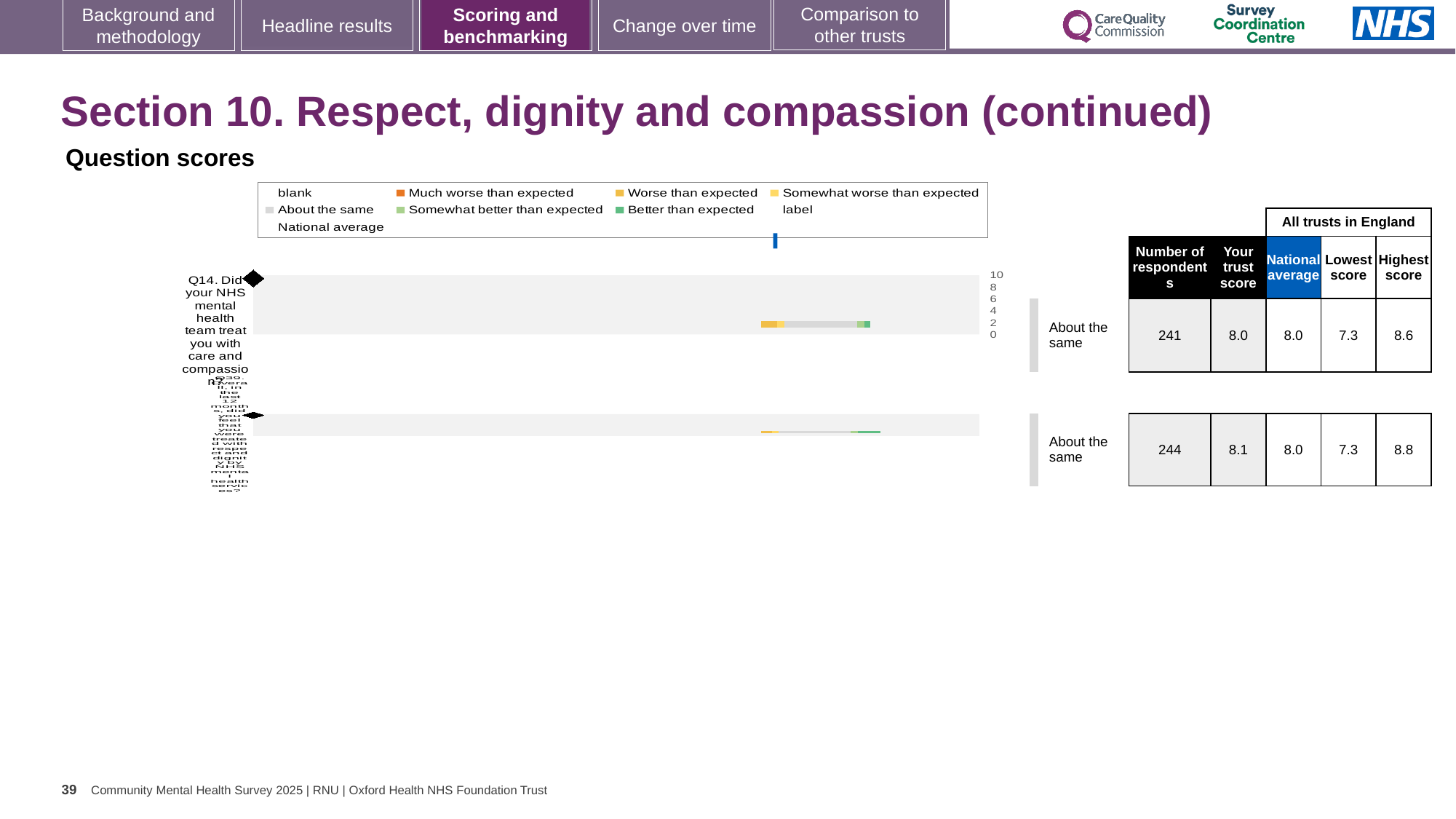
What benchmark category is shown for Q14 (care and compassion)? About the same What kind of chart is used to show the question scores on this slide? bar chart What is the 'Your trust score' value for the second (lower) question row? 8.1 What is the difference between the highest and lowest scores for the second (lower) question row? 1.5 What is the lowest score among all trusts in England for the second (lower) question row? 7.3 How many respondents are recorded for Q14 (care and compassion)? 241 Which question row has the higher number of respondents? the second (lower) question row What is the difference between the highest and lowest scores for Q14 (care and compassion)? 1.3 How many question rows are plotted in the question scores chart? 2 What is the highest score among all trusts in England for Q14 (care and compassion)? 8.6 For the second (lower) question row, which is larger: the trust score or the national average? the trust score What is the 'Your trust score' value for Q14 (care and compassion)? 8.0